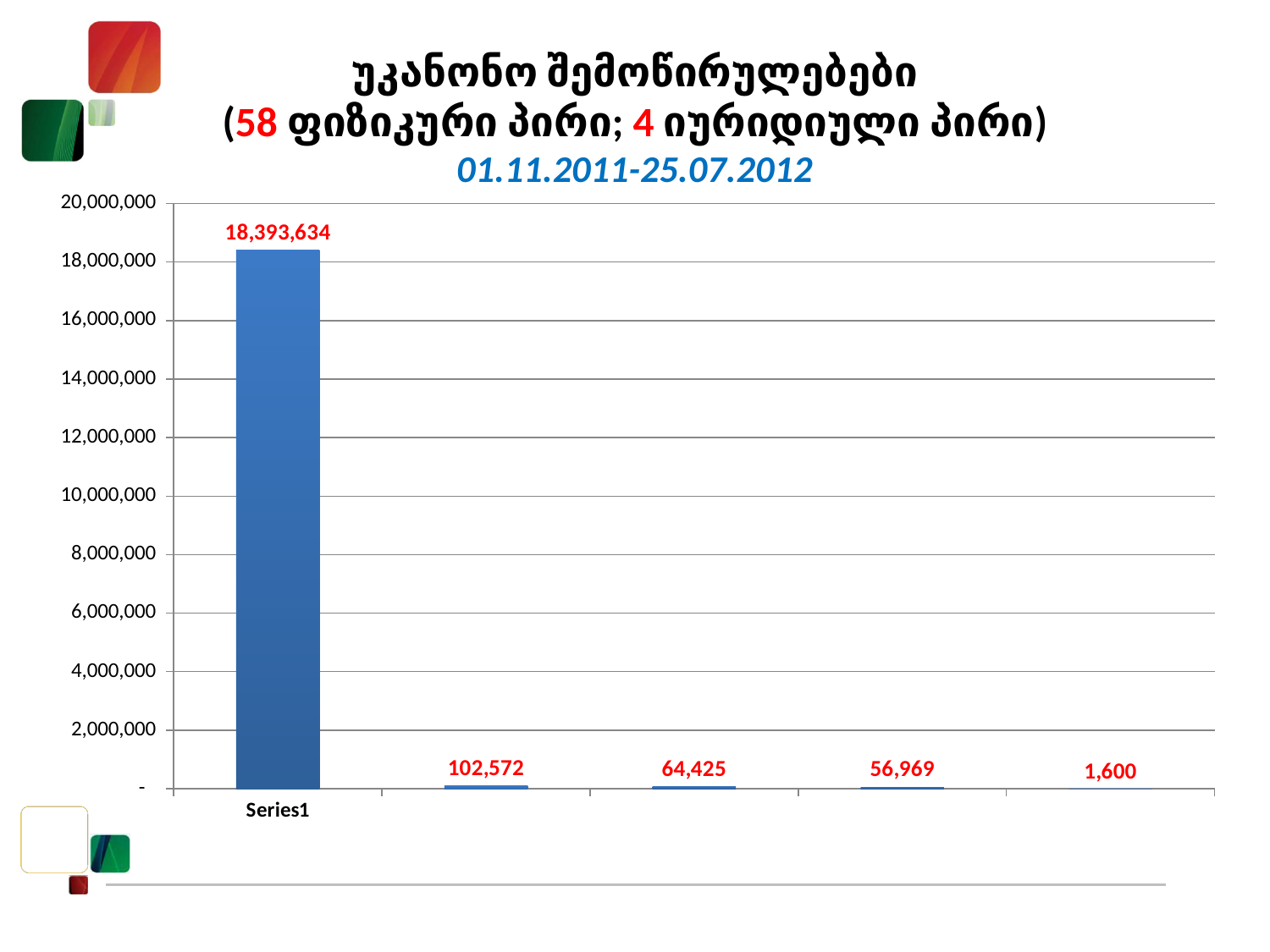
Which is larger, the third bar (64,425) or the fourth bar (56,969)? 64,425 What is the difference between the value for Series1 and the value of the second bar (102,572)? 18,291,062 What is the value printed on the second bar from the left? 102,572 What is the lowest value shown in the chart? 1,600 What is the difference between the bar labelled 64,425 and the bar labelled 56,969? 7,456 What kind of chart is shown on the slide? Bar chart Do the bar values rise or fall from left to right across the chart? Fall What date range is shown in the chart title? 01.11.2011-25.07.2012 What is the value printed on the rightmost bar? 1,600 How many bars are plotted in the chart? 5 What is the highest value shown in the chart? 18,393,634 What value is shown for Series1 in the chart? 18,393,634